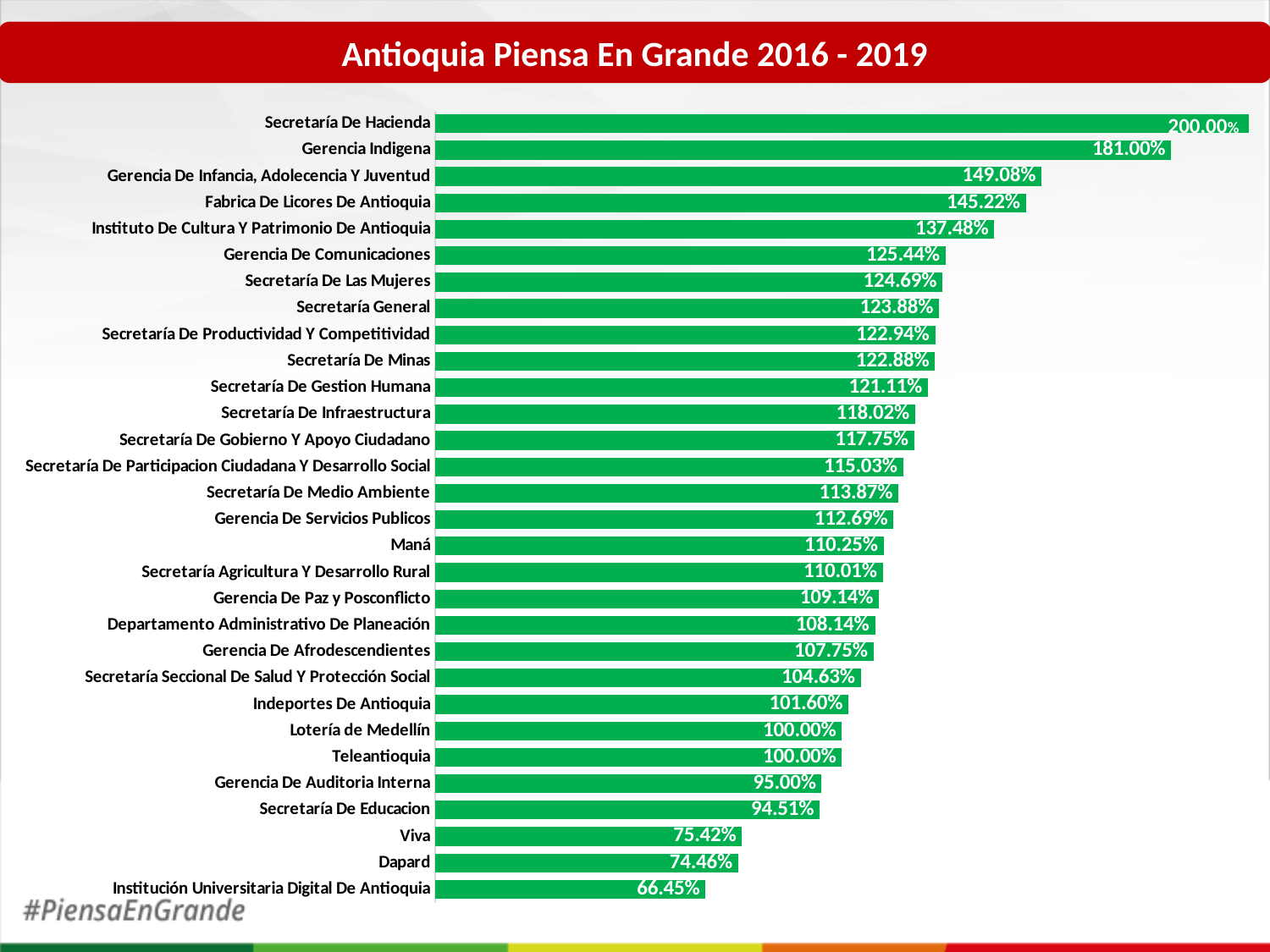
What is the value for Maná? 110.25% What is the difference between the values for Gerencia Indigena and Gerencia De Infancia, Adolecencia Y Juventud? 31.92% What is the difference between the values for Secretaría De Hacienda and Institución Universitaria Digital De Antioquia? 133.55% What is the value for Gerencia Indigena? 181.00% Which category has the lowest value? Institución Universitaria Digital De Antioquia What kind of chart is shown on the slide? Bar chart How many categories are shown in the chart? 30 Which is larger, the value for Viva or the value for Gerencia De Auditoria Interna? Gerencia De Auditoria Interna What is the value for Fabrica De Licores De Antioquia? 145.22% Which category has the highest value? Secretaría De Hacienda What is the title of the slide? Antioquia Piensa En Grande 2016 - 2019 What is the value for Secretaría De Educacion? 94.51%